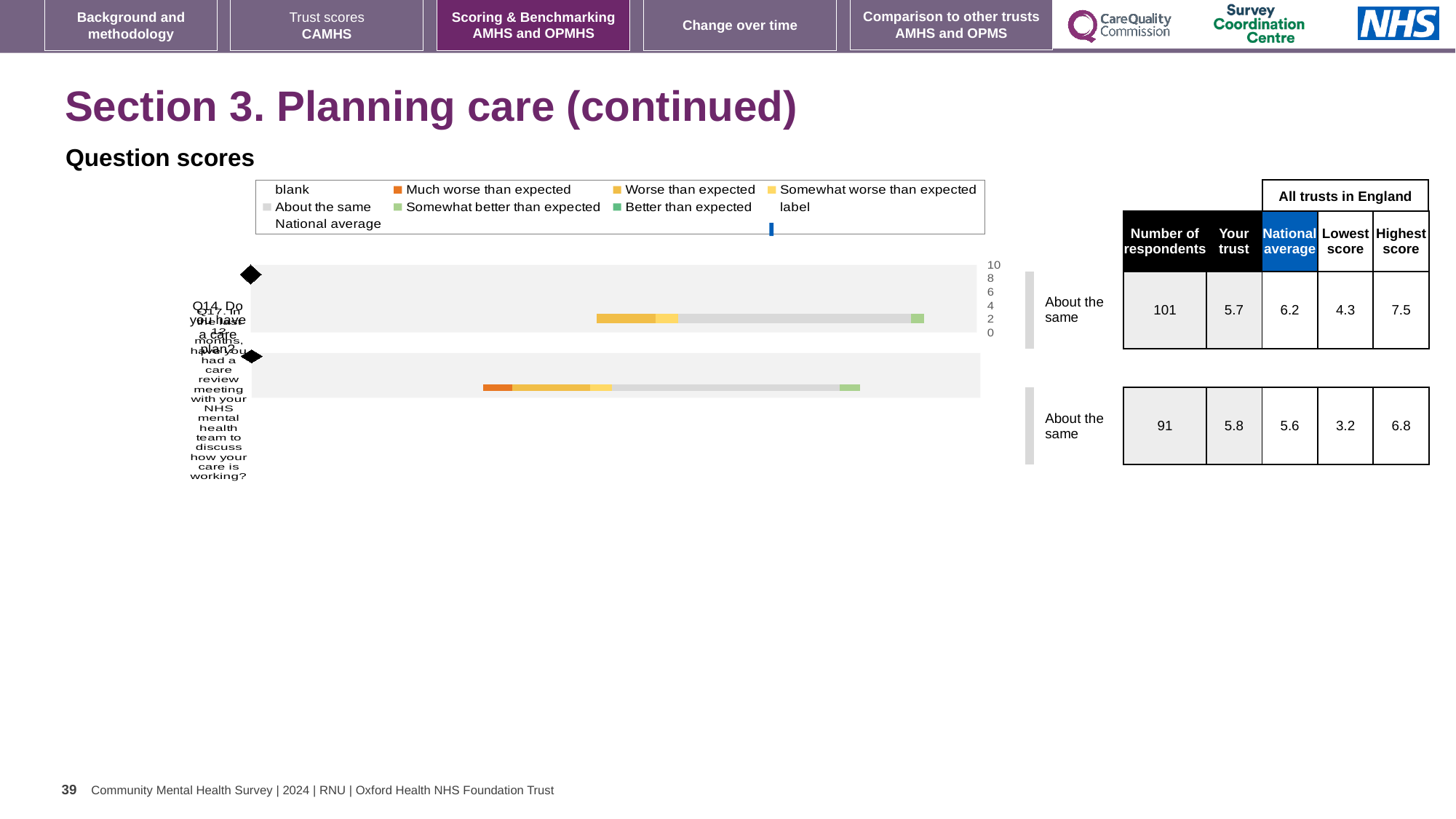
What is the highest score among all trusts in England for the second (bottom) question row? 6.8 What benchmark category is shown next to both question bars? About the same What is the number of respondents for the first (top) question row? 101 What is the lowest score among all trusts in England for the second (bottom) question row? 3.2 How many question bars are plotted in the chart? 2 What is the number of respondents for the second (bottom) question row? 91 For the first (top) question row, which is larger: the 'Your trust' score or the national average? National average For the second (bottom) question row, which is larger: the 'Your trust' score or the national average? Your trust What is the national average for the first (top) question row? 6.2 What is the 'Your trust' score for the first (top) question row? 5.7 What is the difference between the highest score and the lowest score for the first (top) question row? 3.2 What kind of chart is shown under 'Question scores'? bar chart